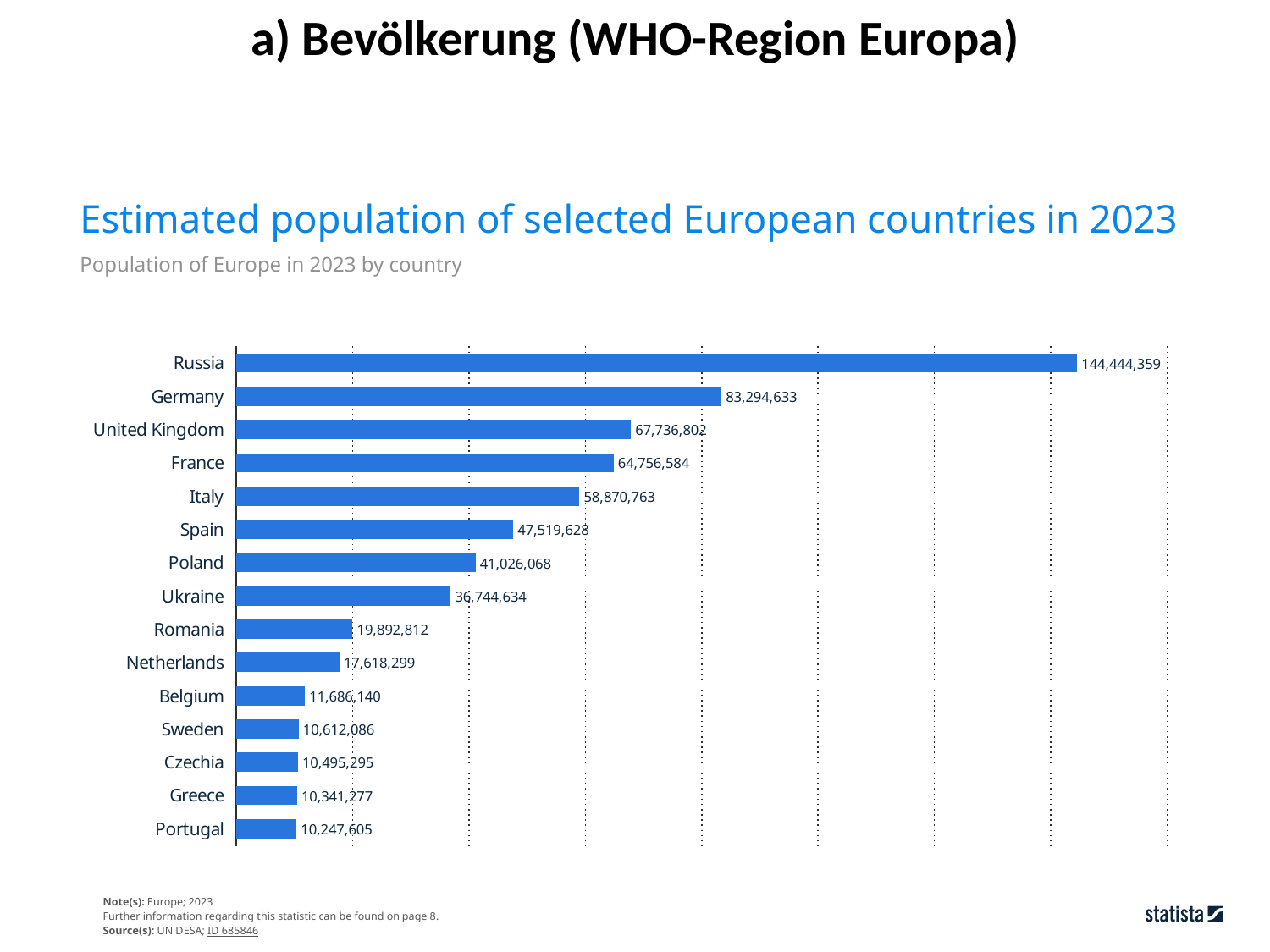
What kind of chart is used to show the population data? Bar chart Which has the larger estimated population, France or Italy? France What is the estimated population of Ukraine shown on the chart? 36,744,634 What is the difference between the populations of Germany and the United Kingdom? 15,557,831 What is the estimated population of Germany in 2023 shown on the chart? 83,294,633 How many countries are shown on the chart? 15 Which country has the lowest estimated population on the chart? Portugal What is the estimated population of Portugal shown on the chart? 10,247,605 Which has the larger estimated population, Romania or the Netherlands? Romania What is the title of the chart? Estimated population of selected European countries in 2023 What is the difference between the populations of Russia and Germany? 61,149,726 Which country has the highest estimated population on the chart? Russia